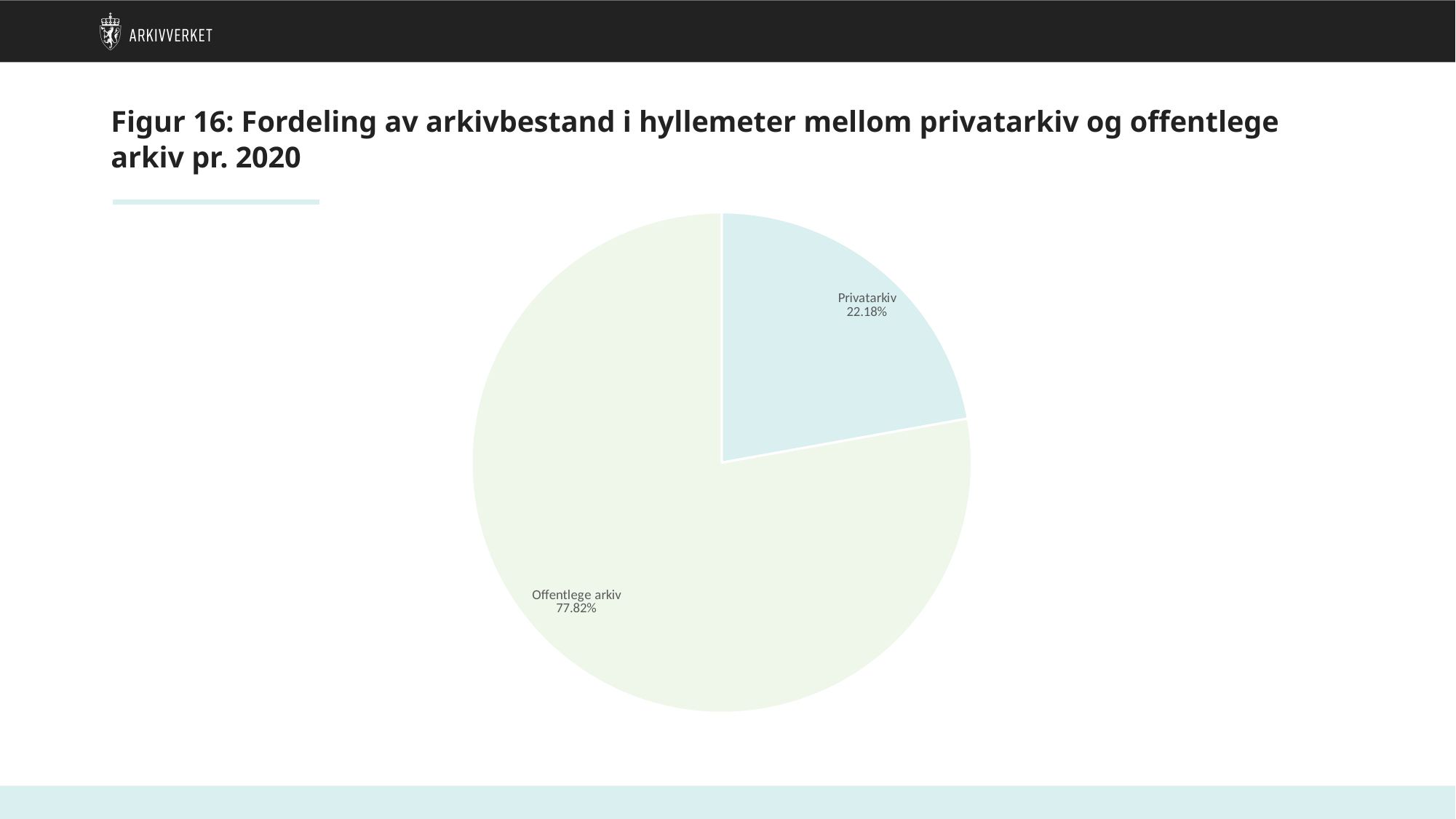
Which category has the smallest slice of the pie? Privatarkiv What share of the pie does Offentlege arkiv represent? 77.82% How many slices does the pie chart have? 2 Which slice of the pie is coloured light blue? Privatarkiv Which is larger, the share for Privatarkiv or the share for Offentlege arkiv? Offentlege arkiv What is the title of the chart on the slide? Figur 16: Fordeling av arkivbestand i hyllemeter mellom privatarkiv og offentlege arkiv pr. 2020 What share of the pie does Privatarkiv represent? 22.18% What is the difference in percentage points between Offentlege arkiv and Privatarkiv? 55.64 What kind of chart is shown on the slide? Pie chart Which category has the largest slice of the pie? Offentlege arkiv